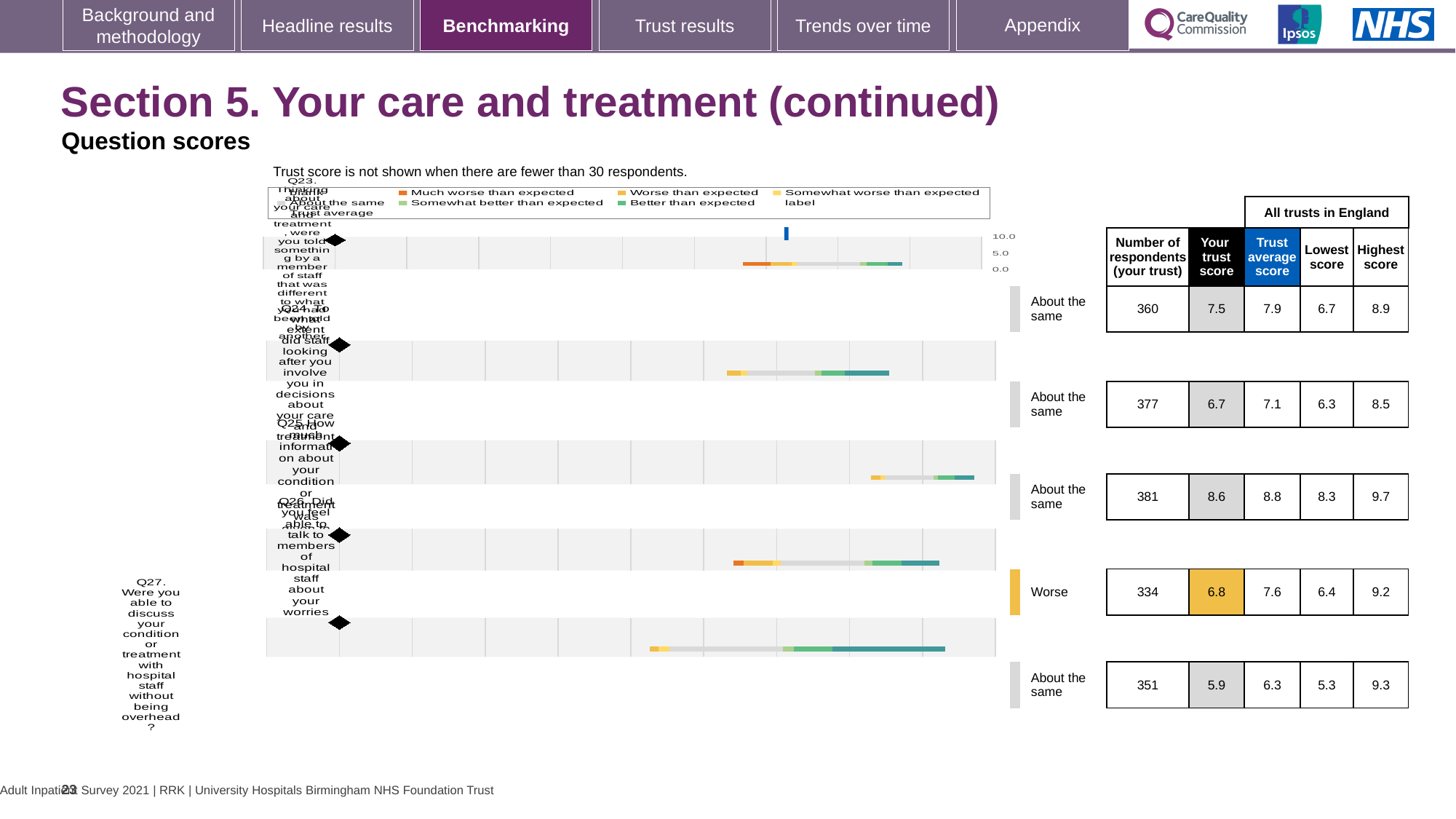
What kind of chart is used to show the question scores? Bar chart How many respondents answered Q25 (How much information about your condition or treatment was given to you)? 381 Which question has the lowest 'Your trust score' on this slide? Q27 What is the trust average score for Q24 (To what extent did staff involve you in decisions about your care and treatment)? 7.1 How many questions are plotted on the chart? 5 What is the highest score across all trusts in England for Q27 (Were you able to discuss your condition or treatment with hospital staff without being overheard)? 9.3 Which has the higher trust score, Q23 or Q24? Q23 What is the trust score for Q26 (Did you feel able to talk to members of hospital staff about your worries)? 6.8 Which question is rated 'Worse' rather than 'About the same'? Q26 What is the difference between the highest score and the lowest score for Q25? 1.4 What is the difference between the trust average score and your trust score for Q26? 0.8 Which question has the highest 'Your trust score' on this slide? Q25